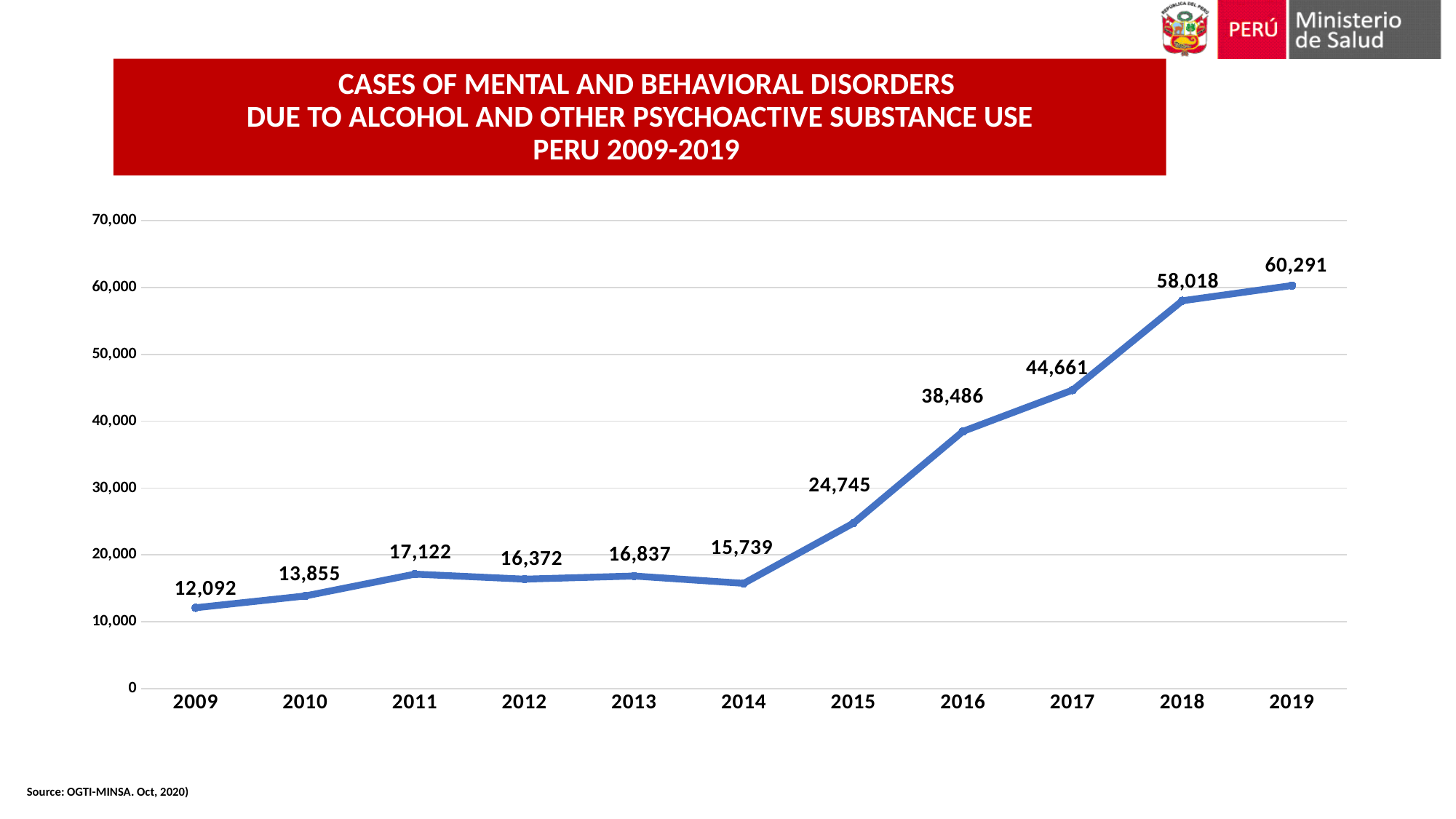
Which year has more cases, 2011 or 2014? 2011 What is the number of cases in 2016? 38,486 What kind of chart is shown on the slide? line chart What is the number of cases in 2009? 12,092 Which year has the highest number of cases? 2019 Which year has the lowest number of cases? 2009 How many years are plotted on the x axis? 11 Do the values generally rise or fall from 2014 to 2019? rise What is the difference in cases between 2018 and 2017? 13,357 Is the value for 2015 greater or less than 20,000? greater What is the number of cases in 2019? 60,291 What is the source cited at the bottom of the slide? OGTI-MINSA. Oct, 2020